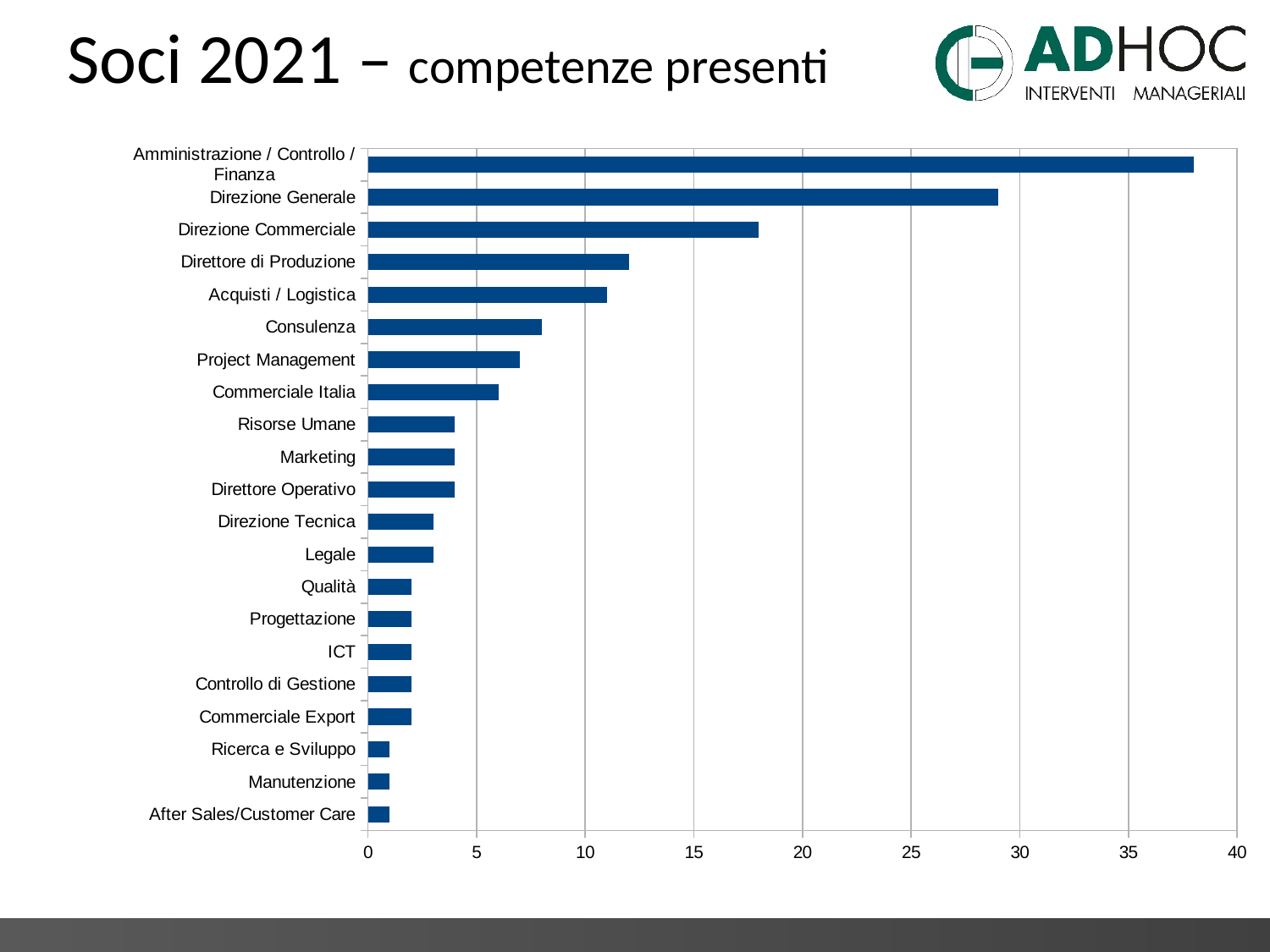
What is the title of the slide containing the chart? Soci 2021 – competenze presenti Is the value for Consulenza greater or less than 10? less Is the value for Direttore di Produzione greater or less than 10? greater Which is larger, the value for Acquisti / Logistica or the value for Commerciale Italia? Acquisti / Logistica How many categories are shown in the chart? 21 What kind of chart is shown on the slide? bar chart Is the value for Legale greater or less than 5? less Which category has the highest value in the chart? Amministrazione / Controllo / Finanza Which is larger, the value for Direzione Generale or the value for Direzione Commerciale? Direzione Generale